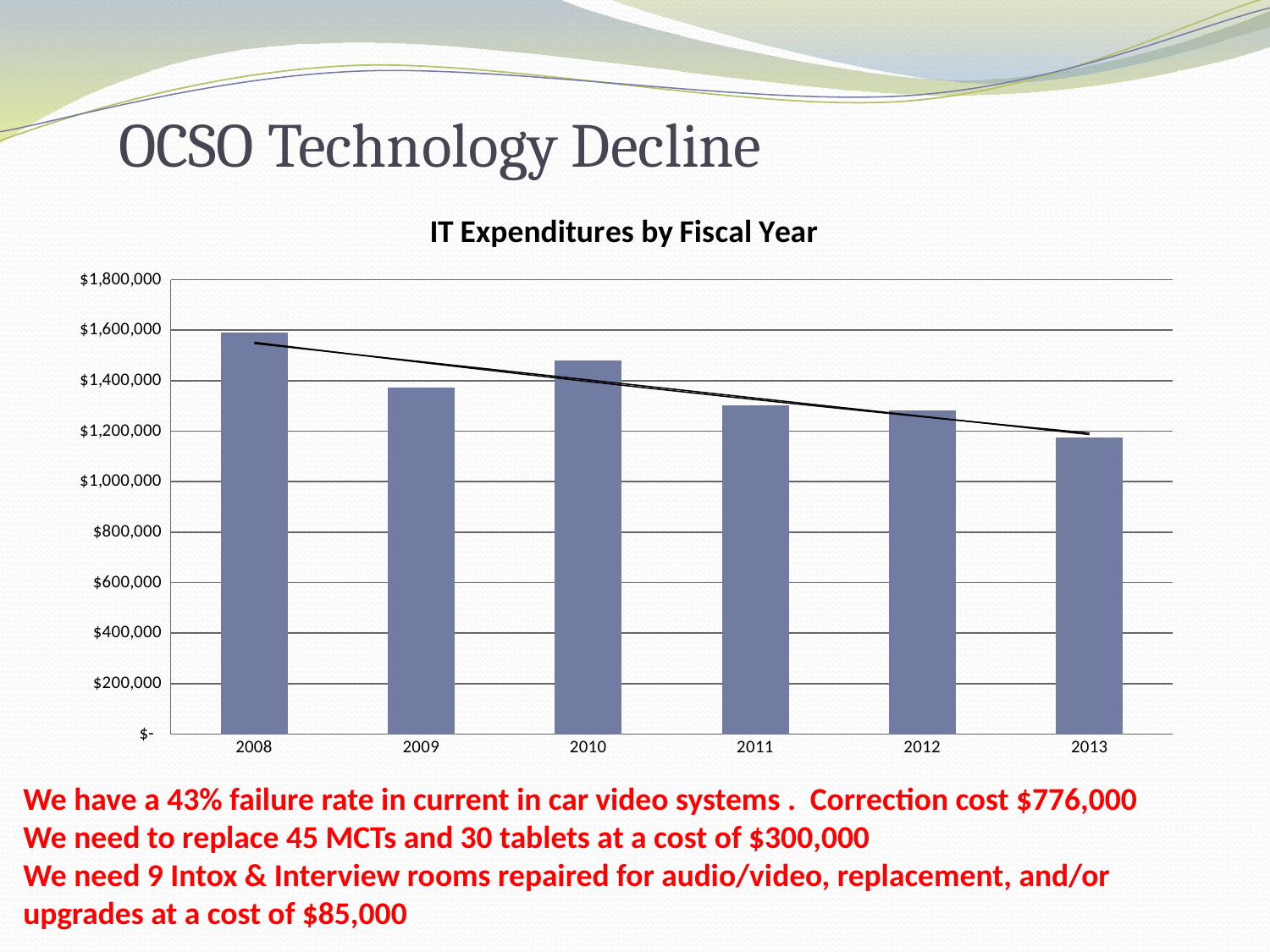
Is the IT expenditure for 2013 greater or less than $1,200,000? less Which fiscal year has the highest IT expenditure? 2008 Is the IT expenditure for 2008 greater or less than $1,400,000? greater What is the title of the chart? IT Expenditures by Fiscal Year Which year has the larger IT expenditure, 2008 or 2013? 2008 Which fiscal year has the lowest IT expenditure? 2013 How many fiscal years are plotted on the chart? 6 Overall, do IT expenditures rise or fall from 2008 to 2013? fall What kind of chart is shown on the slide? bar chart Is the IT expenditure for 2011 greater or less than $1,200,000? greater Which year has the larger IT expenditure, 2009 or 2010? 2010